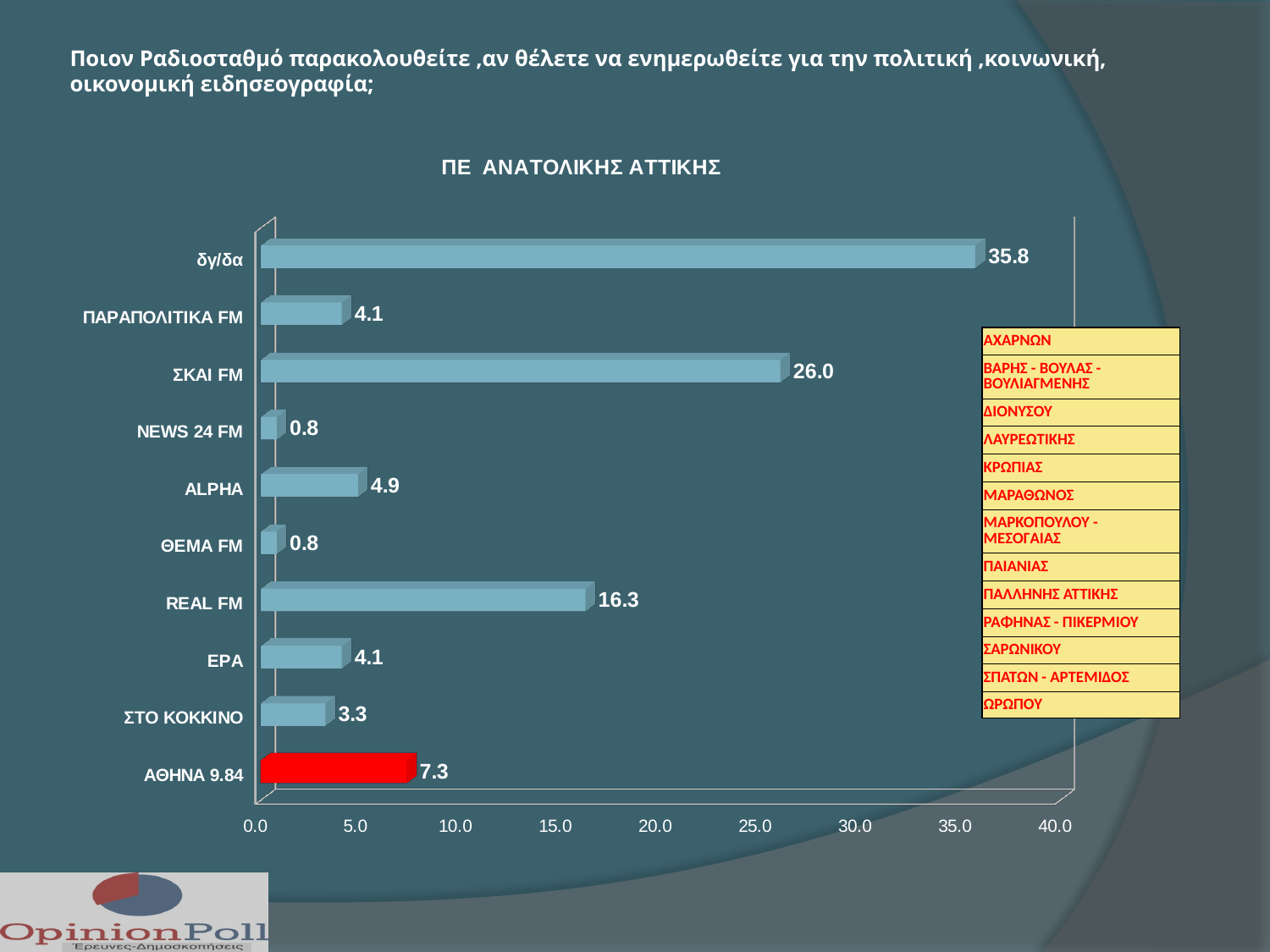
Which bar is coloured red? ΑΘΗΝΑ 9.84 Is the value for δγ/δα greater or less than 35.0? greater What is the title of the chart? ΠΕ ΑΝΑΤΟΛΙΚΗΣ ΑΤΤΙΚΗΣ Which is larger, the value for ALPHA or the value for ΣΤΟ ΚΟΚΚΙΝΟ? ALPHA Which category has the highest value? δγ/δα What is the difference between the values for ΣΚΑΙ FM and REAL FM? 9.7 What kind of chart is shown on the slide? bar chart What is the value for ΣΚΑΙ FM? 26.0 What is the value for REAL FM? 16.3 What is the value for ΠΑΡΑΠΟΛΙΤΙΚΑ FM? 4.1 What is the value for ΑΘΗΝΑ 9.84? 7.3 How many categories are shown on the chart? 10